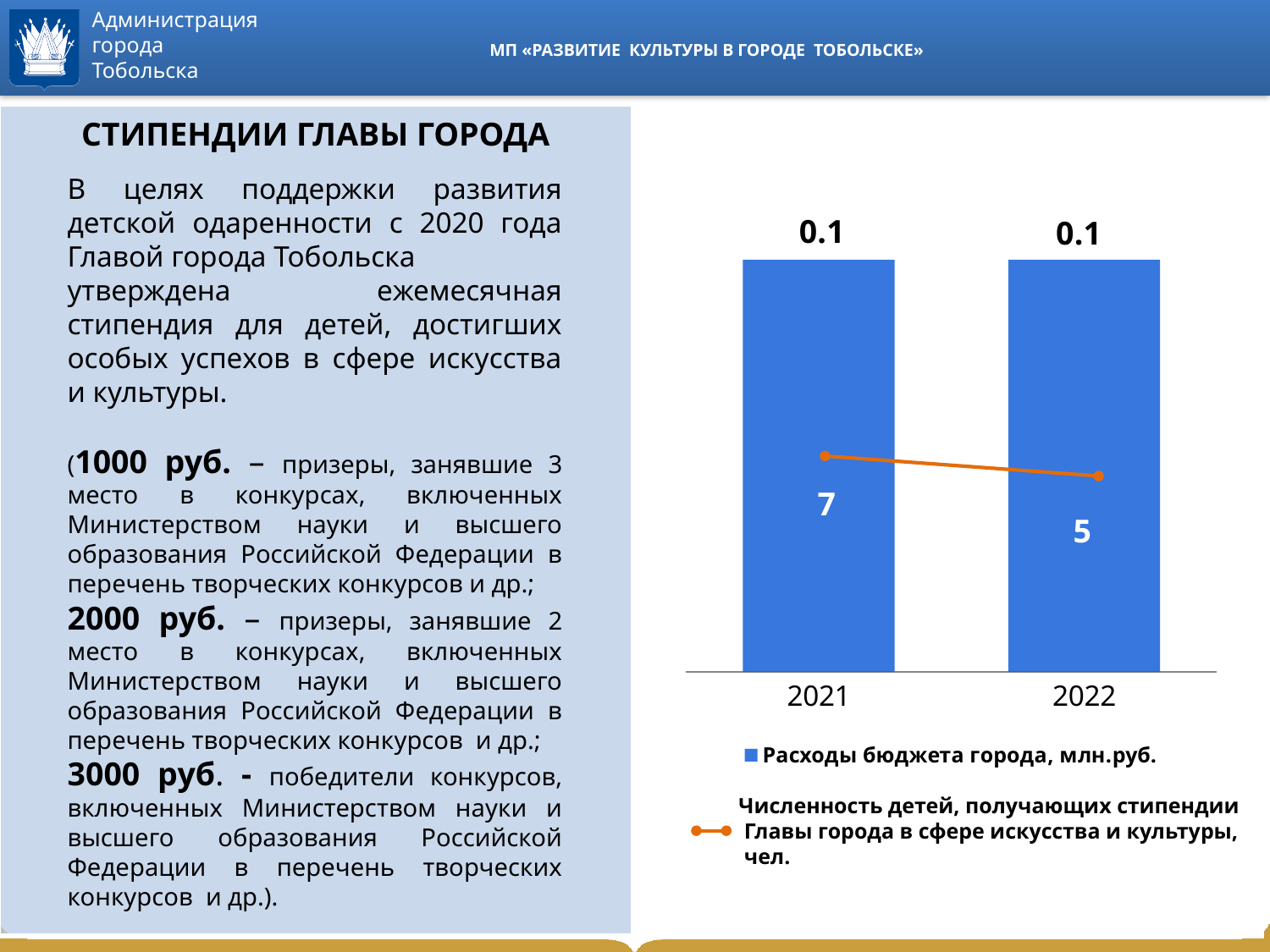
What is the value of 'Расходы бюджета города, млн.руб.' for 2022? 0.1 What is the value of 'Расходы бюджета города, млн.руб.' for 2021? 0.1 How many children received the Head of City scholarship (Численность детей, получающих стипендии) in 2022? 5 In which year was the number of children receiving scholarships highest? 2021 Does the number of children receiving scholarships rise or fall from 2021 to 2022? fall How many children received the Head of City scholarship (Численность детей, получающих стипендии) in 2021? 7 By how much did the number of children receiving scholarships change from 2021 to 2022? 2 In which year was the number of children receiving scholarships lowest? 2022 How many years (categories) are shown on the x axis of the chart? 2 How many series does the chart legend list? 2 What colour are the bars representing 'Расходы бюджета города, млн.руб.'? blue Which year has more children receiving scholarships, 2021 or 2022? 2021